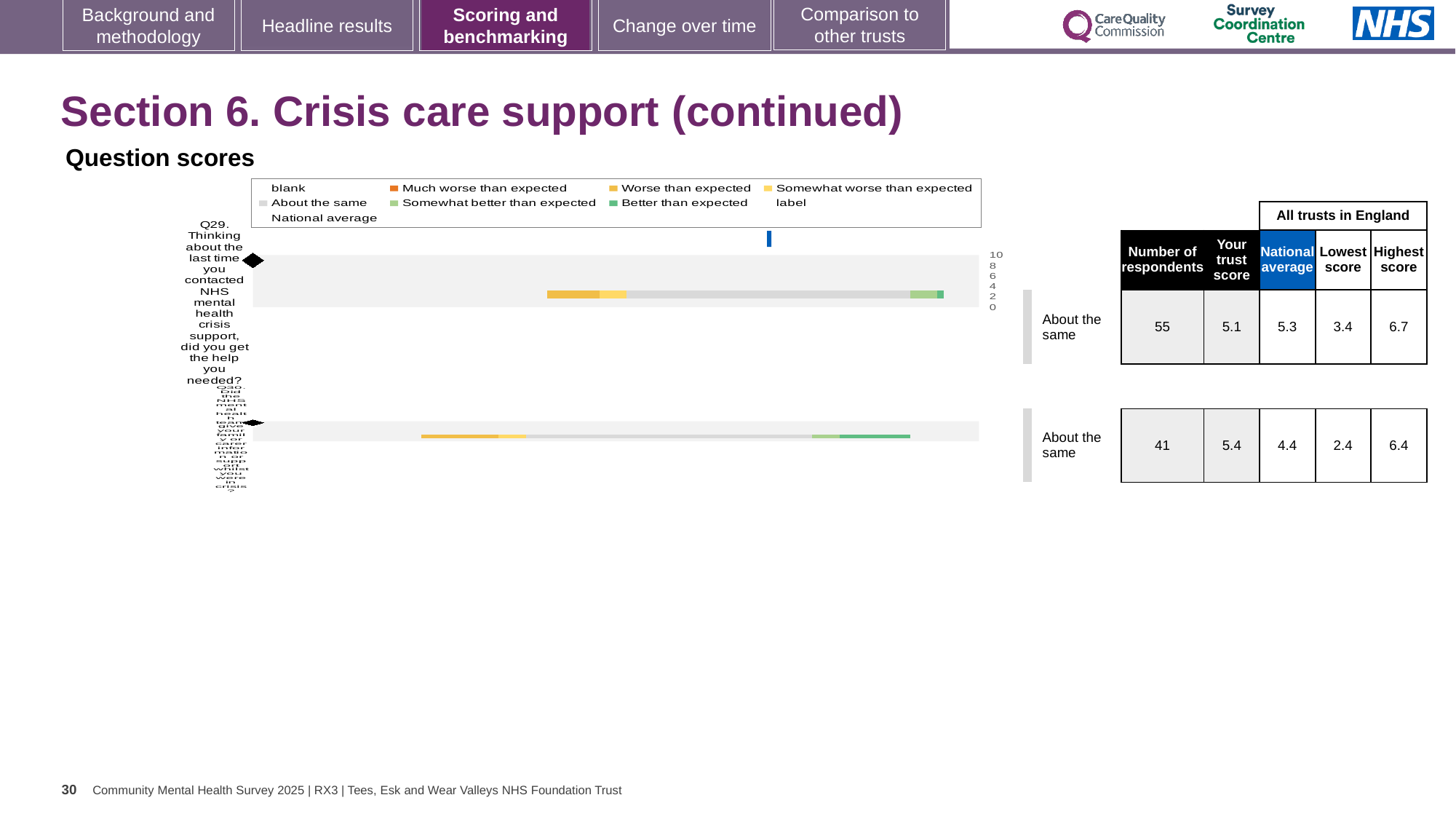
What is the national average for Q30 shown in the table next to the chart? 4.4 What is the difference between the highest score and the lowest score for Q30? 4.0 How many respondents answered Q29? 55 What is the lowest score across all trusts in England for Q30? 2.4 How many survey questions are plotted in the question scores chart? 2 What kind of chart is used to show the question scores on this slide? bar chart What is the trust score for Q29 shown in the table next to the chart? 5.1 For Q30, which is larger: the trust score or the national average? Your trust score For Q29, which is larger: the trust score or the national average? National average Which question had more respondents, Q29 or Q30? Q29 What is the difference between the national average and the trust score for Q29? 0.2 What benchmark category label is shown for both Q29 and Q30? About the same